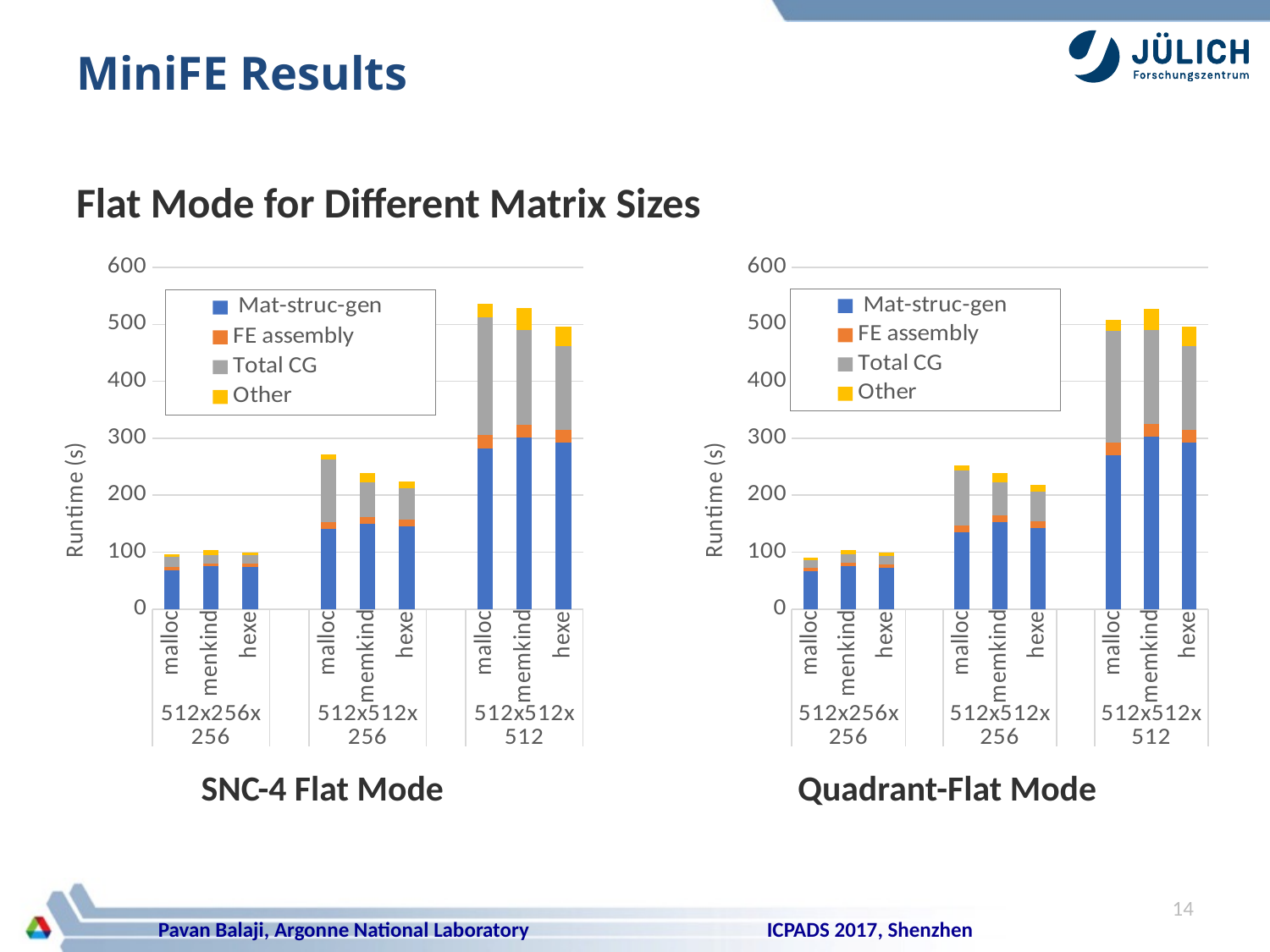
What kind of chart is the SNC-4 Flat Mode chart? stacked bar chart In the SNC-4 Flat Mode chart, is the total runtime for malloc at 512x512x512 greater or less than 500? greater How many series does the legend of the Quadrant-Flat Mode chart list? 4 In the Quadrant-Flat Mode chart, is the total runtime for hexe at 512x512x256 greater or less than 200? greater In the Quadrant-Flat Mode chart, which has the larger total runtime at 512x512x256: malloc or hexe? malloc What is the y-axis label of the SNC-4 Flat Mode chart? Runtime (s) In the SNC-4 Flat Mode chart, which has the larger total runtime at 512x512x512: malloc or hexe? malloc In the Quadrant-Flat Mode chart, is the total runtime for memkind at 512x512x512 greater or less than 500? greater In the SNC-4 Flat Mode chart, which matrix size group has the highest runtimes? 512x512x512 In the Quadrant-Flat Mode chart, do the malloc runtimes rise or fall as the matrix size increases from 512x256x256 to 512x512x512? rise In the SNC-4 Flat Mode chart, how many bars are plotted in total? 9